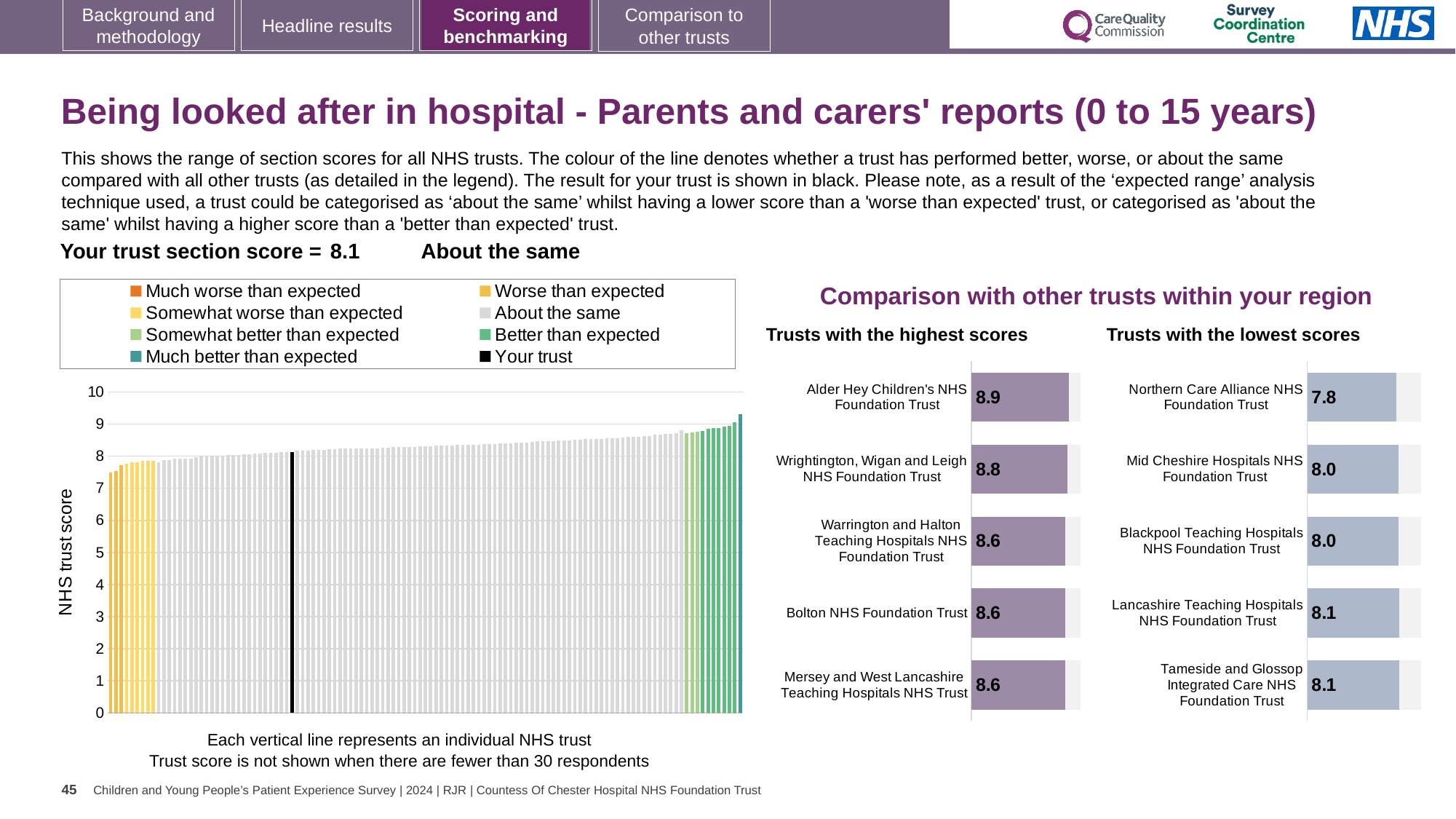
In the large chart on the left, is the value of the tallest bar greater or less than 9? greater In the 'Trusts with the lowest scores' chart, what is the score for Northern Care Alliance NHS Foundation Trust? 7.8 In the 'Trusts with the lowest scores' chart, which trust has the lowest score? Northern Care Alliance NHS Foundation Trust In the 'Trusts with the highest scores' chart, which trust has the highest score? Alder Hey Children's NHS Foundation Trust How many entries does the legend of the large chart on the left list? 8 What kind of chart is the large chart on the left showing NHS trust scores? bar chart In the 'Trusts with the highest scores' chart, what is the score for Alder Hey Children's NHS Foundation Trust? 8.9 In the large chart on the left, do the bar values rise or fall from left to right? rise In the 'Trusts with the highest scores' chart, which has the larger score: Alder Hey Children's NHS Foundation Trust or Wrightington, Wigan and Leigh NHS Foundation Trust? Alder Hey Children's NHS Foundation Trust What is the difference between the score for Alder Hey Children's NHS Foundation Trust in the 'highest scores' chart and the score for Northern Care Alliance NHS Foundation Trust in the 'lowest scores' chart? 1.1 In the 'Trusts with the lowest scores' chart, what is the score for Mid Cheshire Hospitals NHS Foundation Trust? 8.0 How many trusts are shown in the 'Trusts with the lowest scores' chart? 5